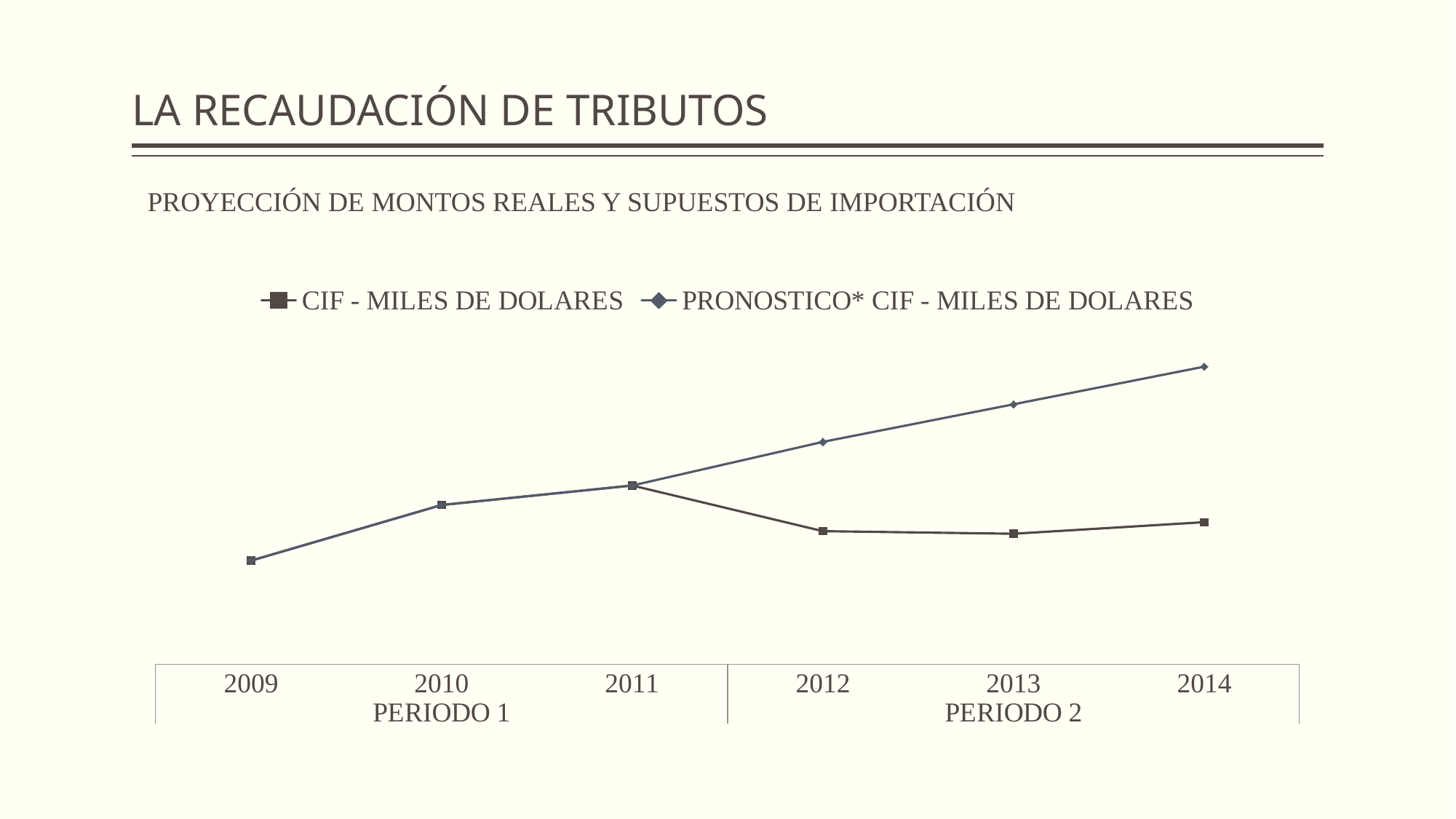
How many series does the legend list? 2 In which year does the PRONOSTICO* CIF - MILES DE DOLARES series reach its highest value? 2014 What is the subtitle shown above the chart? PROYECCIÓN DE MONTOS REALES Y SUPUESTOS DE IMPORTACIÓN In 2014, which series has the higher value, CIF - MILES DE DOLARES or PRONOSTICO* CIF - MILES DE DOLARES? PRONOSTICO* CIF - MILES DE DOLARES Does the CIF - MILES DE DOLARES series rise or fall from 2011 to 2012? fall For the CIF - MILES DE DOLARES series, is the value in 2014 higher or lower than in 2013? higher What kind of chart is shown on the slide? line chart Does the PRONOSTICO* CIF - MILES DE DOLARES series rise or fall from 2011 to 2014? rise In which year does the CIF - MILES DE DOLARES series reach its highest value? 2011 In which year does the CIF - MILES DE DOLARES series have its lowest value? 2009 How many years are shown on the x axis? 6 Which period label groups the years 2012, 2013 and 2014 on the x axis? PERIODO 2